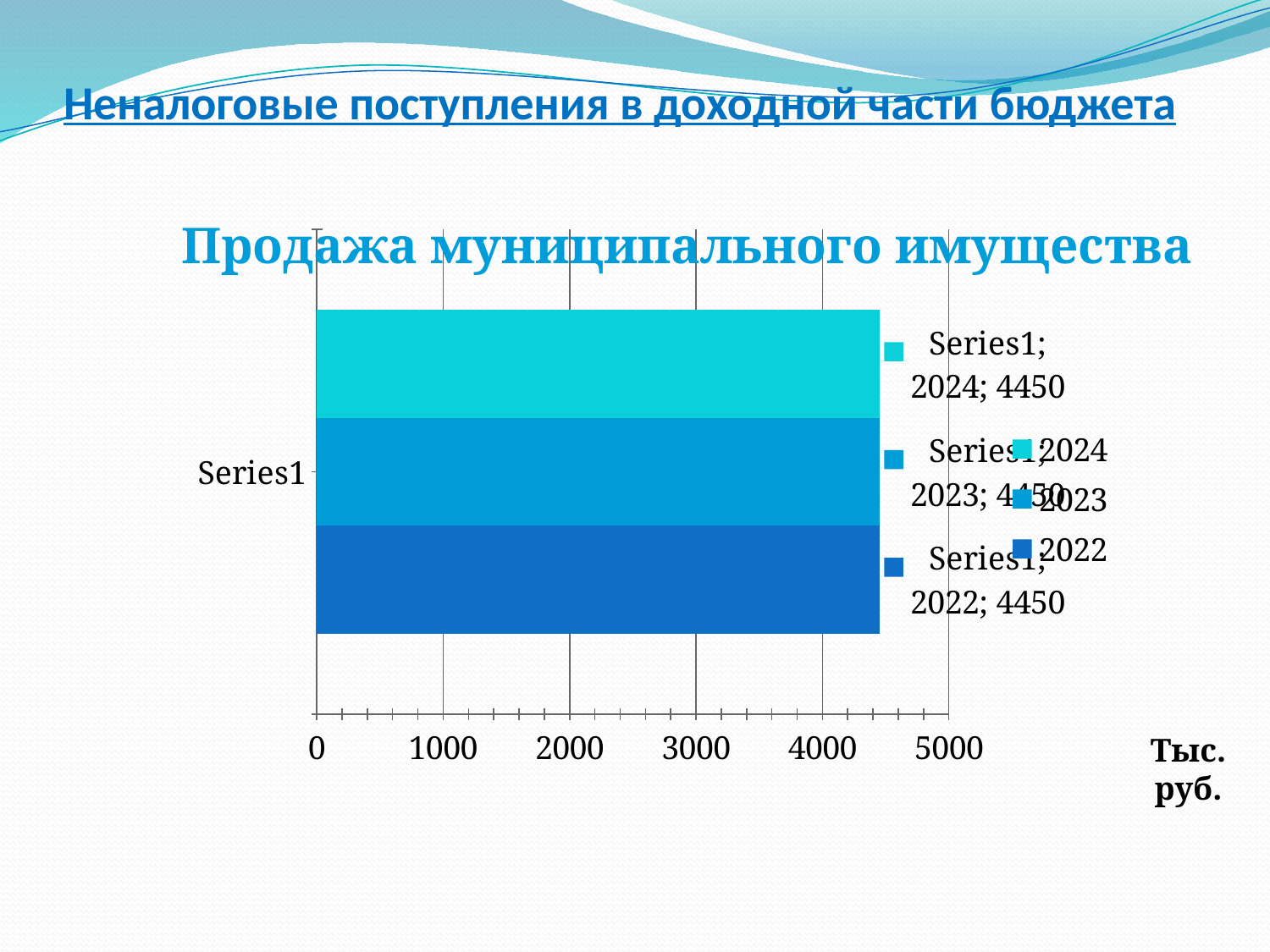
How many bars are plotted in the chart? 3 What is the difference between the values for 2024 and 2022? 0 What is the value for 2023 in the chart? 4450 What kind of chart is shown on the slide? bar chart What is the title of the chart? Продажа муниципального имущества What unit is indicated next to the horizontal axis? Тыс. руб. What is the value for 2022 in the chart? 4450 How many entries does the legend list? 3 Is the value for 2022 greater or less than 5000? less Do the values change from 2022 to 2024? No, they stay the same Is the value for 2023 greater or less than 4000? greater What is the value for 2024 in the chart? 4450